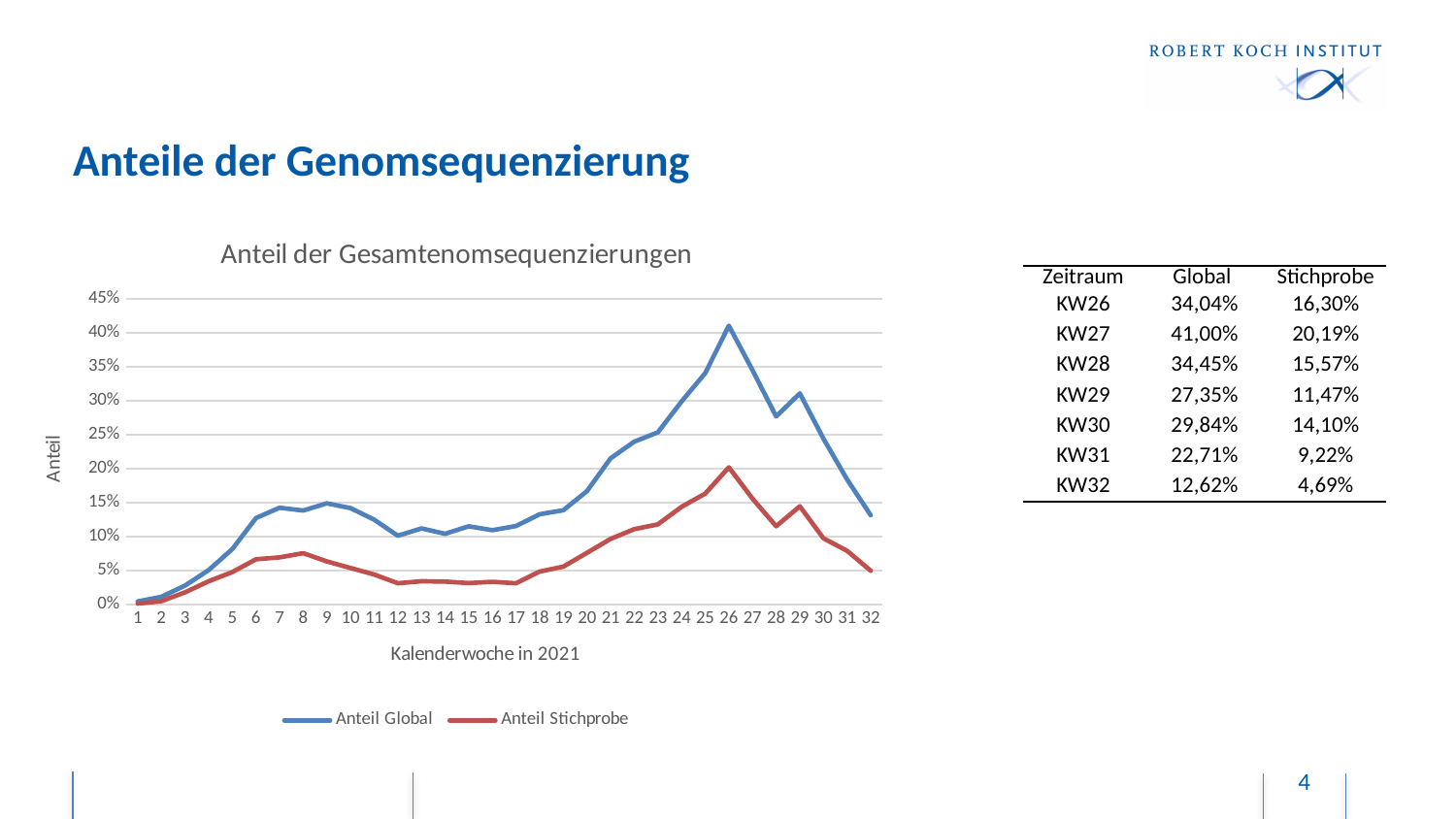
According to the table, what is the Global share for KW27? 41,00% What kind of chart is shown on the slide? line chart According to the table, what is the Stichprobe share for KW26? 16,30% How many series does the chart legend list? 2 In which calendar week does the Anteil Global series reach its highest value? 26 According to the table, what is the difference between the Global and Stichprobe shares in KW26? 17,74% Is the value of Anteil Global in calendar week 6 greater or less than 10%? greater Is the value of Anteil Stichprobe in calendar week 12 greater or less than 5%? less In calendar week 20, which series has the larger value, Anteil Global or Anteil Stichprobe? Anteil Global Is the value of Anteil Global in calendar week 26 greater or less than 40%? greater Does the Anteil Global series rise or fall from calendar week 29 to week 32? fall How many calendar weeks are plotted along the x axis of the chart? 32